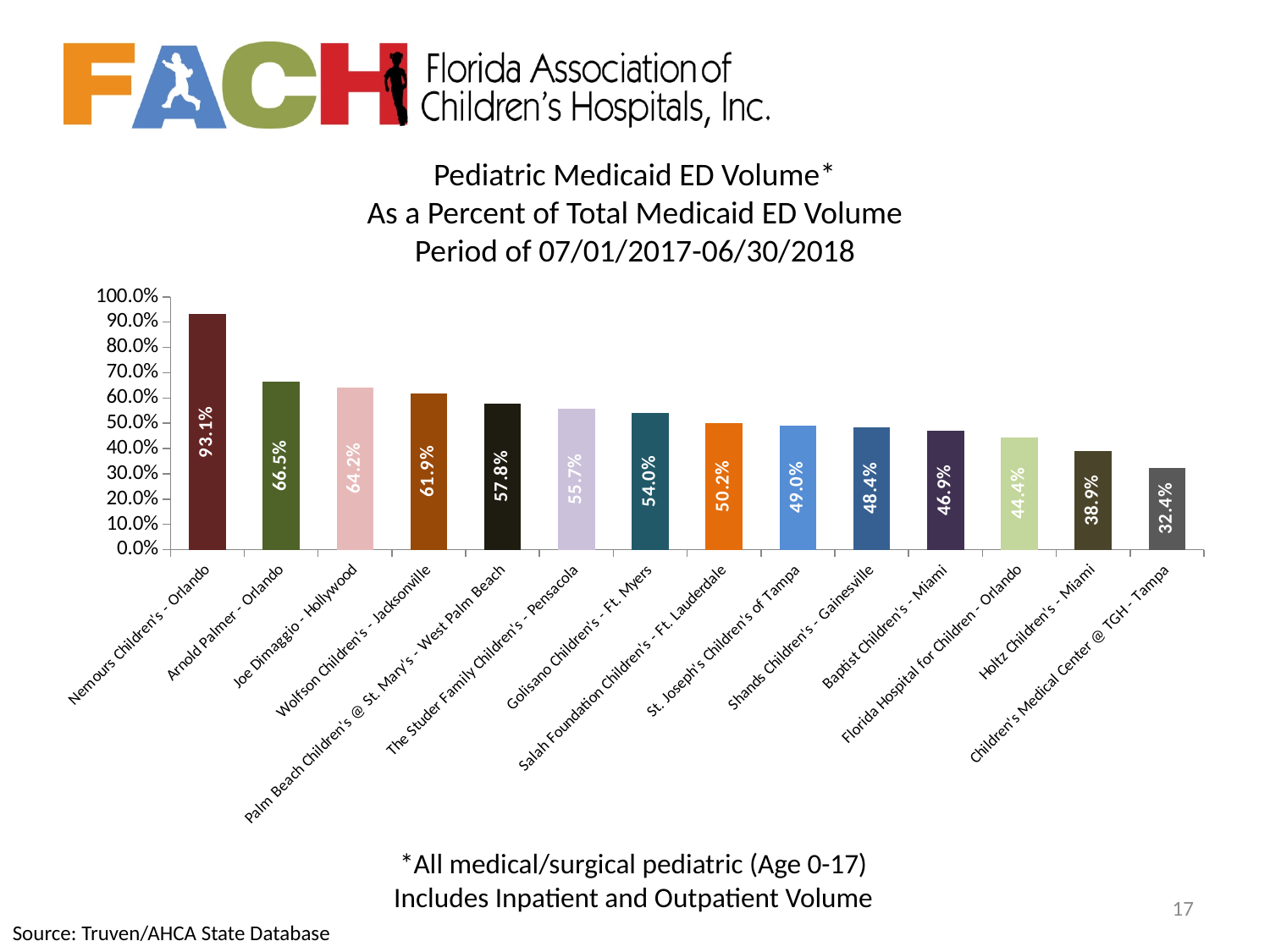
What is the value for Nemours Children's - Orlando? 93.1% What is the difference between the values for Arnold Palmer - Orlando and Holtz Children's - Miami? 27.6% What period does the chart title say the data covers? 07/01/2017-06/30/2018 What is the value for Shands Children's - Gainesville? 48.4% Which is larger, the value for Joe Dimaggio - Hollywood or the value for Golisano Children's - Ft. Myers? Joe Dimaggio - Hollywood How many hospitals are shown in the chart? 14 What kind of chart is shown on the slide? bar chart Which hospital has the lowest Pediatric Medicaid ED Volume percentage? Children's Medical Center @ TGH - Tampa Is the value for Baptist Children's - Miami greater or less than 50.0%? less Do the values rise or fall from left to right across the chart? fall What is the value for Wolfson Children's - Jacksonville? 61.9% Which hospital has the highest Pediatric Medicaid ED Volume percentage? Nemours Children's - Orlando